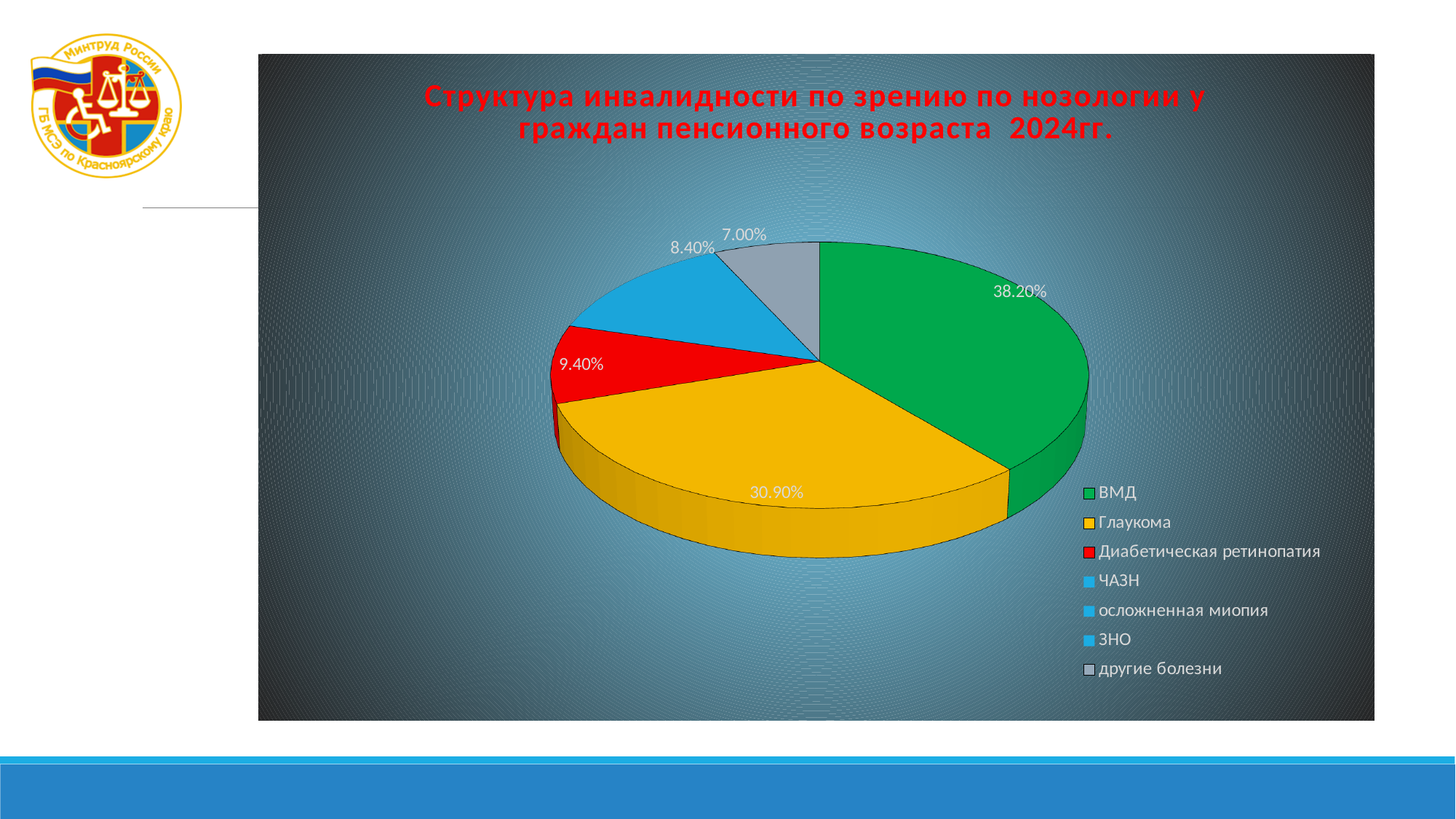
What is the value labelled on the Диабетическая ретинопатия slice? 9.40% Which category has the largest slice of the pie? ВМД What type of chart is shown on the slide? Pie chart What percentage is shown for другие болезни? 7.00% How many slices have a percentage label printed on the pie? 5 What percentage is shown for Глаукома? 30.90% By how many percentage points does ВМД exceed Глаукома? 7.30 percentage points Which is larger, the share for Глаукома or for Диабетическая ретинопатия? Глаукома Which labelled slice is the smallest in the pie chart? другие болезни How many entries does the legend list? 7 What colour is the ВМД slice? Green What percentage does the ВМД slice represent in the pie chart? 38.20%